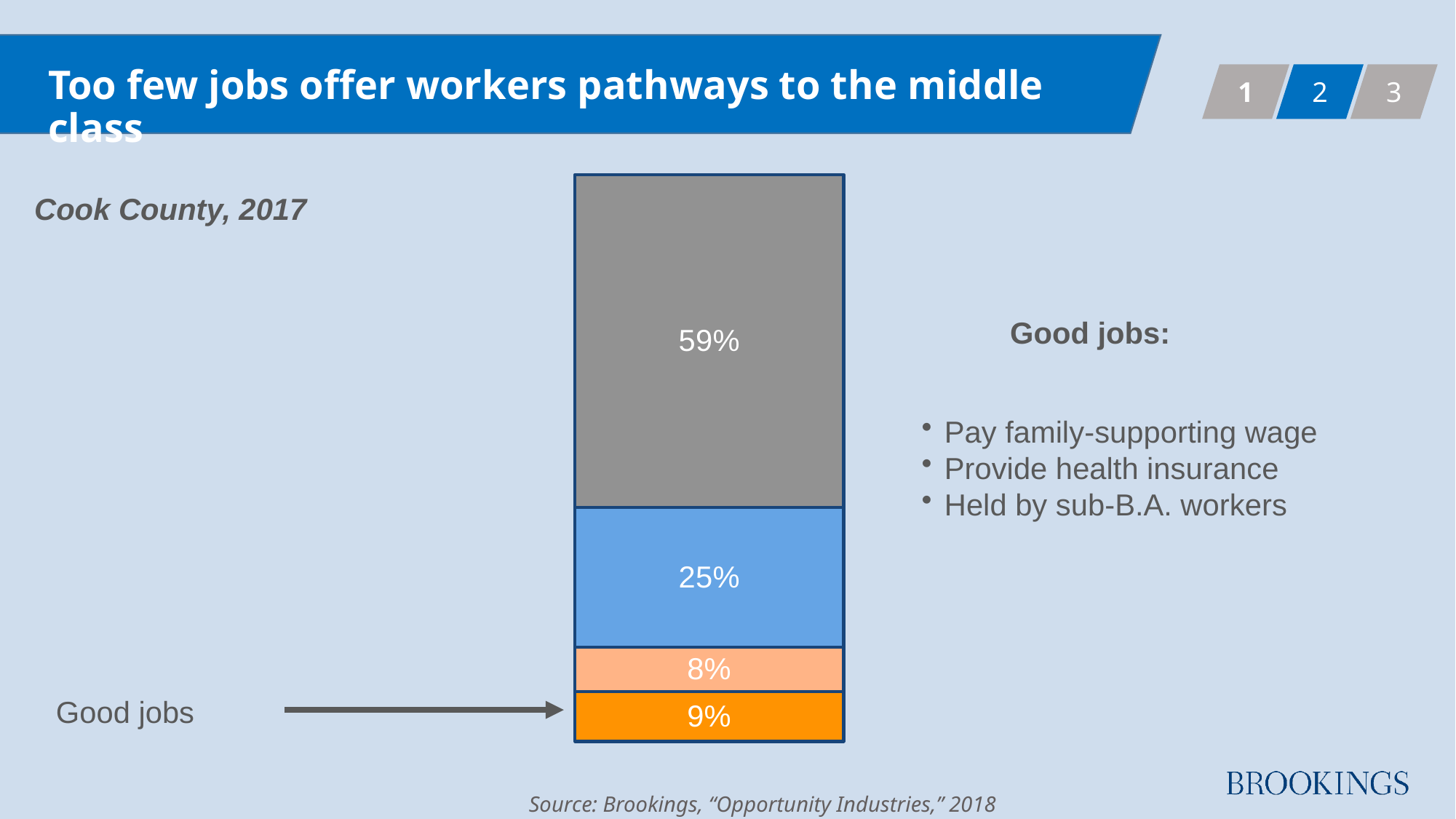
What kind of chart is shown on the slide? Stacked bar chart What value is printed on the blue segment of the stacked bar? 25% What is the difference between the good jobs segment (9%) and the light orange segment (8%)? 1% How many segments make up the stacked bar? 4 Which is larger, the blue segment or the good jobs segment? The blue segment (25%) Which segment of the stacked bar has the smallest value? The light orange segment (8%) What is the total of all segments in the stacked bar? 101% What value is printed on the light orange segment just above the good jobs segment? 8% Which segment of the stacked bar has the largest value? The gray top segment (59%) What value is printed on the gray top segment of the stacked bar? 59% What share of jobs in Cook County, 2017 are labeled as good jobs on the chart? 9% What is the difference between the gray segment (59%) and the blue segment (25%)? 34%